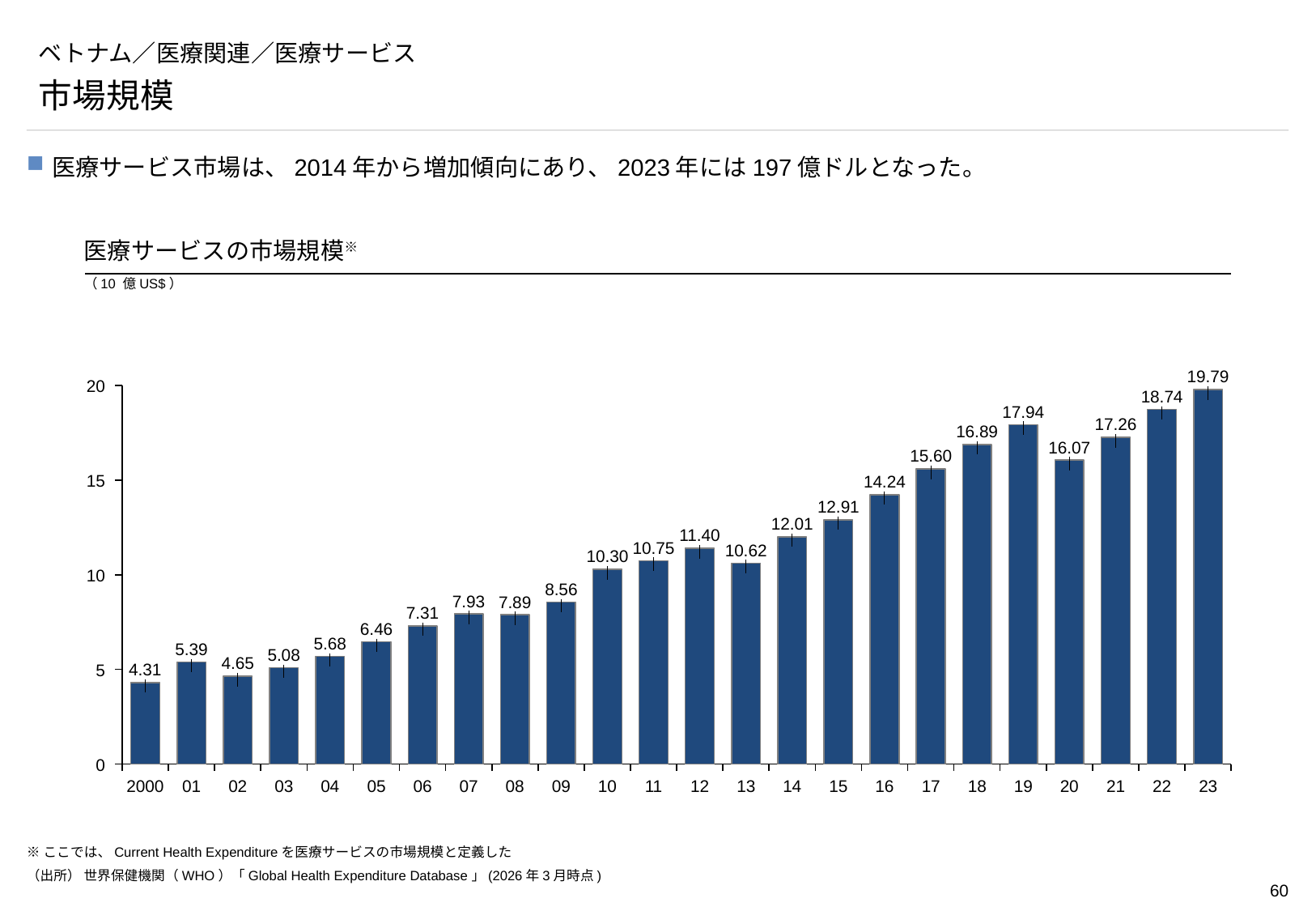
Which year has the lowest value in the 医療サービスの市場規模 chart? 2000 What is the value for 2000 in the 医療サービスの市場規模 chart? 4.31 Is the value for 2010 in the 医療サービスの市場規模 chart greater or less than 10? greater What kind of chart is the 医療サービスの市場規模 chart? bar chart Which is larger in the 医療サービスの市場規模 chart, the value for 2019 or the value for 2020? 2019 What is the difference between the values for 2023 and 2022 in the 医療サービスの市場規模 chart? 1.05 What is the value for 2013 in the 医療サービスの市場規模 chart? 10.62 What is the value for 2023 in the 医療サービスの市場規模 chart? 19.79 Which year has the highest value in the 医療サービスの市場規模 chart? 23 What unit is shown for the values in the 医療サービスの市場規模 chart? 10 億 US$ Do the values in the 医療サービスの市場規模 chart generally rise or fall from 2000 to 2023? rise How many years are plotted in the 医療サービスの市場規模 chart? 24